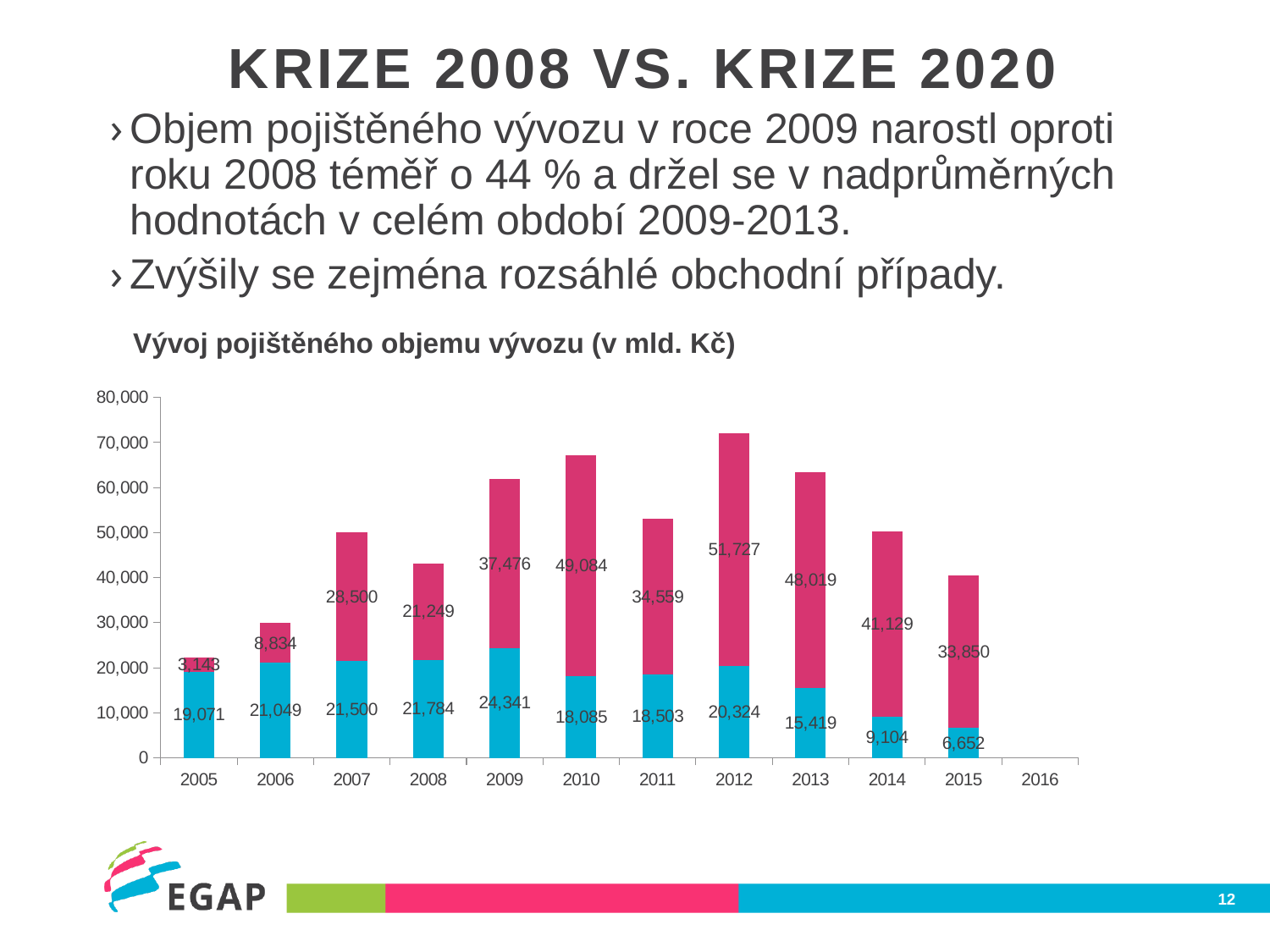
What is the difference between the pink segment values for 2012 and 2013? 3,708 What kind of chart is shown on the slide? stacked bar chart Is the blue segment value for 2008 larger than the blue segment value for 2007? yes What is the value of the pink segment for 2012? 51,727 What is the total of the stacked bar for 2012? 72,051 Which year has the tallest stacked bar overall? 2012 Does the blue segment value rise or fall from 2012 to 2015? fall What is the value of the blue segment for 2009? 24,341 What is the value of the pink segment for 2005? 3,143 Which year has the lowest value in the blue segment? 2015 What is the title of the chart? Vývoj pojištěného objemu vývozu (v mld. Kč) Which year has the highest value in the pink segment? 2012